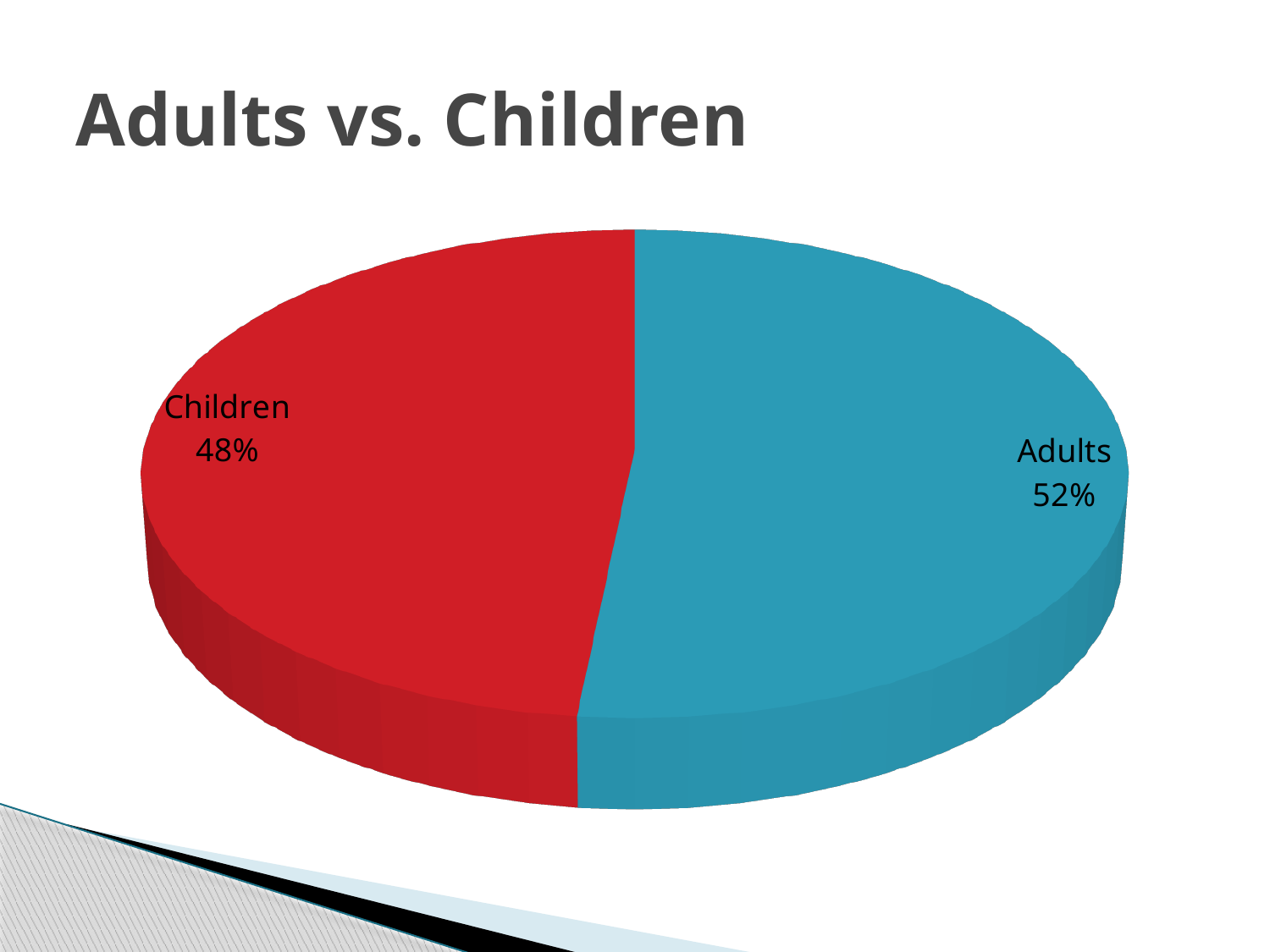
Which is larger, the Adults slice or the Children slice? Adults Which slice is the largest? Adults What share of the pie does the Children slice represent? 48% What kind of chart is shown on the slide? Pie chart What share of the pie does the Adults slice represent? 52% How many slices does the pie chart have? 2 Is the share for Children greater or less than 50%? less Which slice is the smallest? Children What is the title of the slide? Adults vs. Children What colour is the Children slice? Red Is the share for Adults greater or less than 50%? greater What is the difference in percentage points between the Adults and Children slices? 4